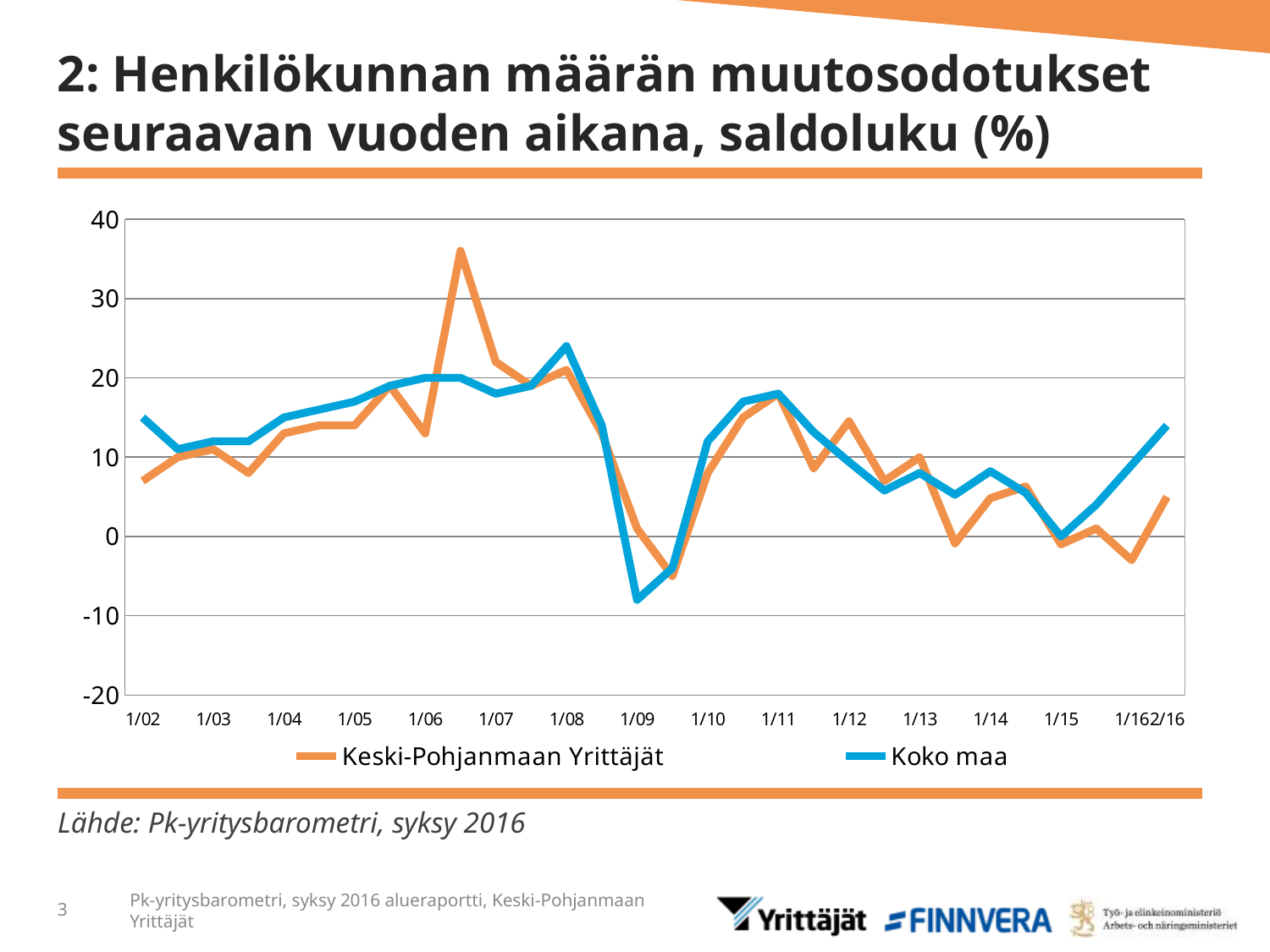
Is the value for Koko maa at 2/16 greater or less than 10? greater At which x-axis point does the Keski-Pohjanmaan Yrittäjät series reach its highest value? between 1/06 and 1/07 Does the Koko maa series rise or fall between 1/15 and 2/16? rise At 2/16, which series has the higher value, Keski-Pohjanmaan Yrittäjät or Koko maa? Koko maa What kind of chart is shown on the slide? line chart At which x-axis label does the Koko maa series reach its lowest value? 1/09 Is the value for Keski-Pohjanmaan Yrittäjät at 2/16 greater or less than 10? less What are the two series named in the legend? Keski-Pohjanmaan Yrittäjät and Koko maa Is the peak value of Keski-Pohjanmaan Yrittäjät greater or less than 30? greater How many series does the legend list? 2 Which series is drawn in blue? Koko maa